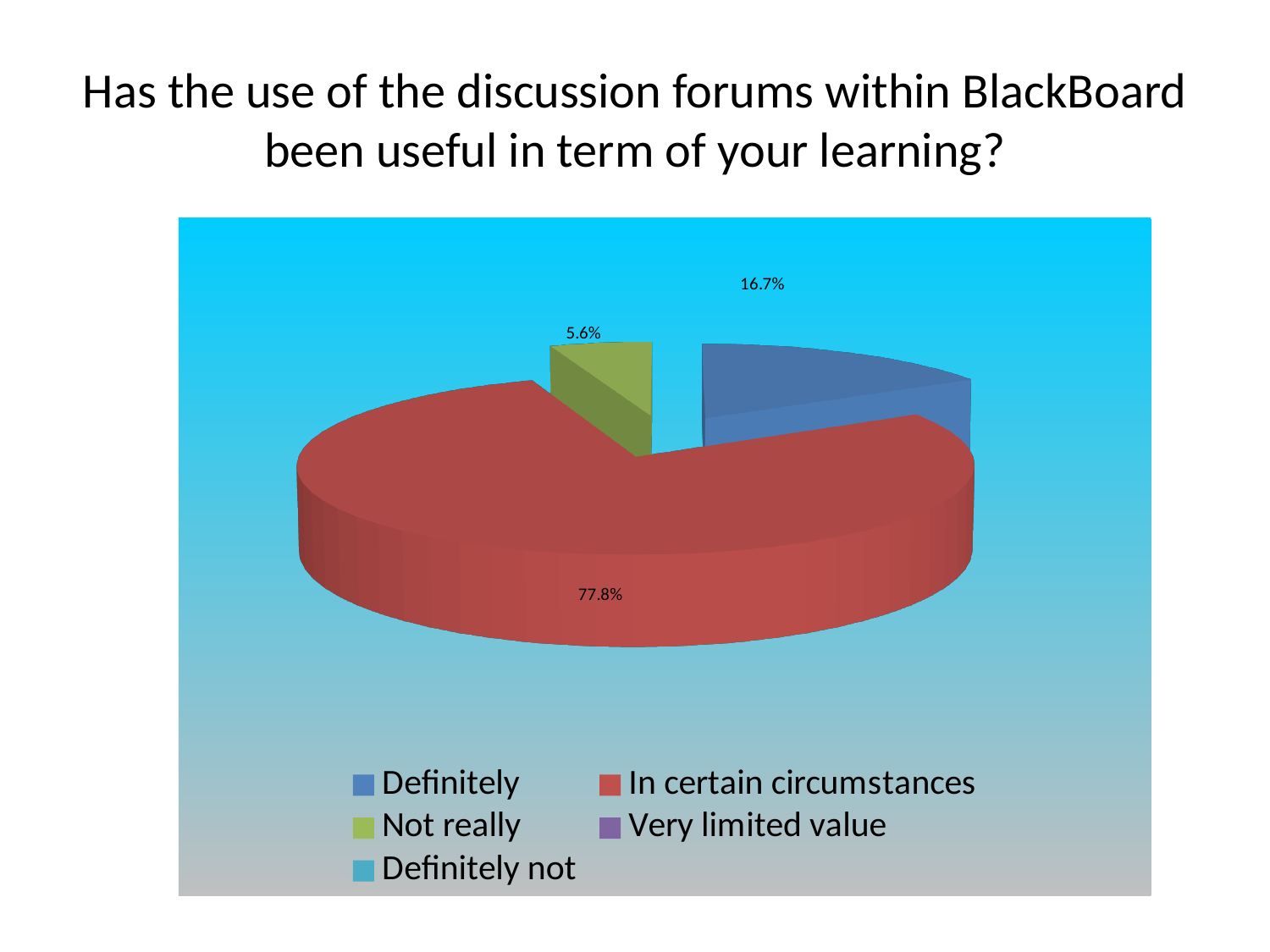
What type of chart is shown on the slide? pie chart What is the difference in percentage points between "Definitely" and "Not really"? 11.1 What percentage of respondents answered "Definitely"? 16.7% What percentage of respondents answered "In certain circumstances"? 77.8% Of the slices with a printed value, which response has the smallest share? Not really What is the title of the slide containing the chart? Has the use of the discussion forums within BlackBoard been useful in term of your learning? Which is larger, the share for "Definitely" or the share for "Not really"? Definitely What is the difference in percentage points between "In certain circumstances" and "Definitely"? 61.1 What percentage of respondents answered "Not really"? 5.6% How many response categories does the legend list? 5 Which response has the largest share of the pie? In certain circumstances What colour is the slice for "In certain circumstances"? red